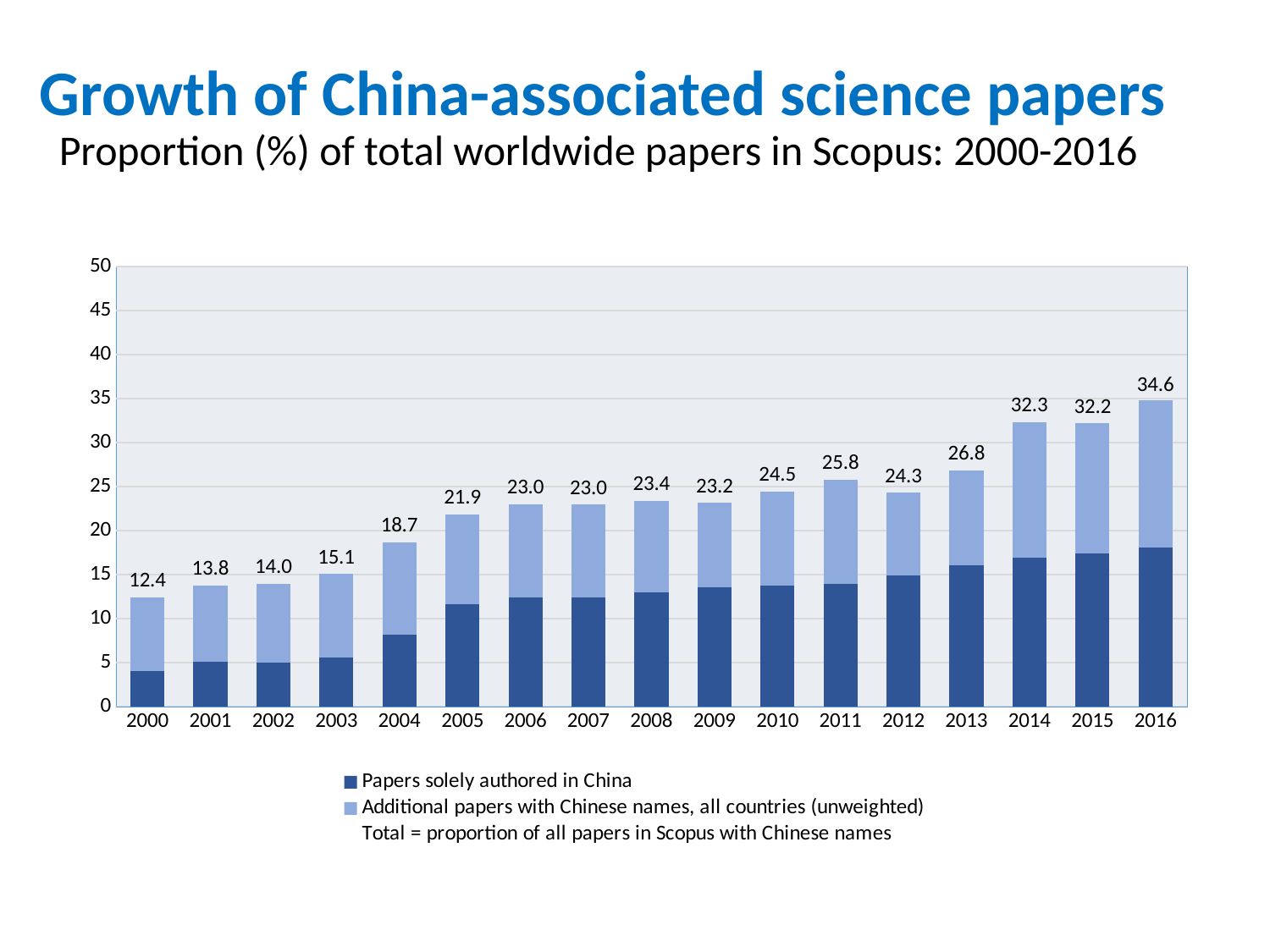
Is the value for 'Papers solely authored in China' in 2016 greater or less than 15? greater What is the total value shown for 2016? 34.6 Which year has a larger total, 2011 or 2012? 2011 How many years are shown on the x axis? 17 Do the totals generally rise or fall from 2000 to 2016? Rise Which year has the highest total? 2016 Is the value for 'Papers solely authored in China' in 2000 greater or less than 5? less What is the total value shown for 2011? 25.8 What kind of chart is shown on the slide? Stacked bar chart What is the difference between the total for 2016 and the total for 2000? 22.2 Which year has the lowest total? 2000 What is the total value shown for 2004? 18.7